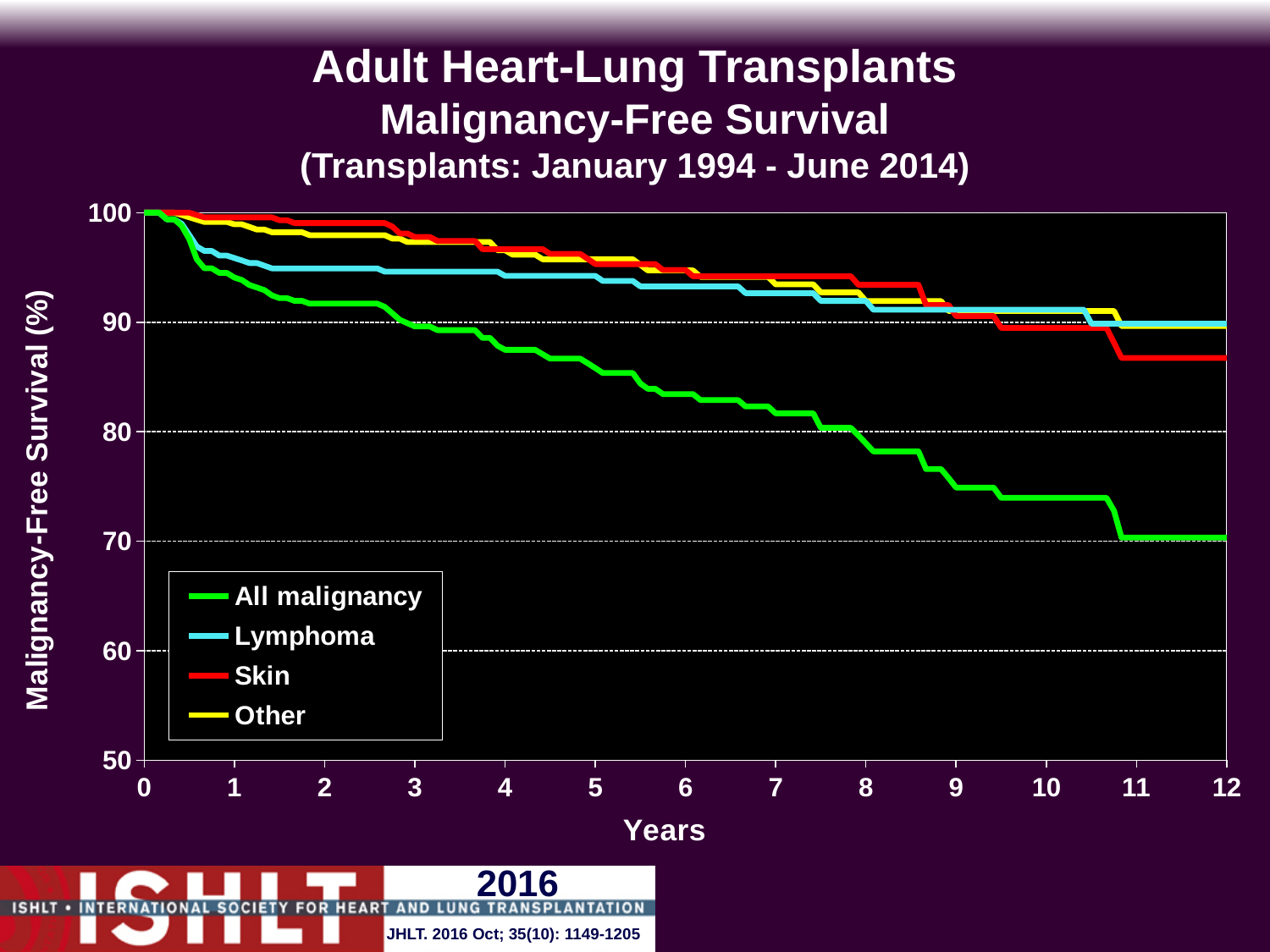
Do the survival curves rise or fall as years increase? Fall Which series has the lowest malignancy-free survival at 12 years? All malignancy Is the value for Lymphoma at 2 years greater or less than 90? greater Is the value for All malignancy at 5 years greater or less than 90? less At 1 year, which series has the higher malignancy-free survival, Lymphoma or Skin? Skin How many series does the legend list? 4 At 12 years, which series has the higher malignancy-free survival, Skin or All malignancy? Skin What is the label of the y axis? Malignancy-Free Survival (%) Is the value for Skin at 12 years greater or less than 90? less What kind of chart is shown on the slide? Line chart